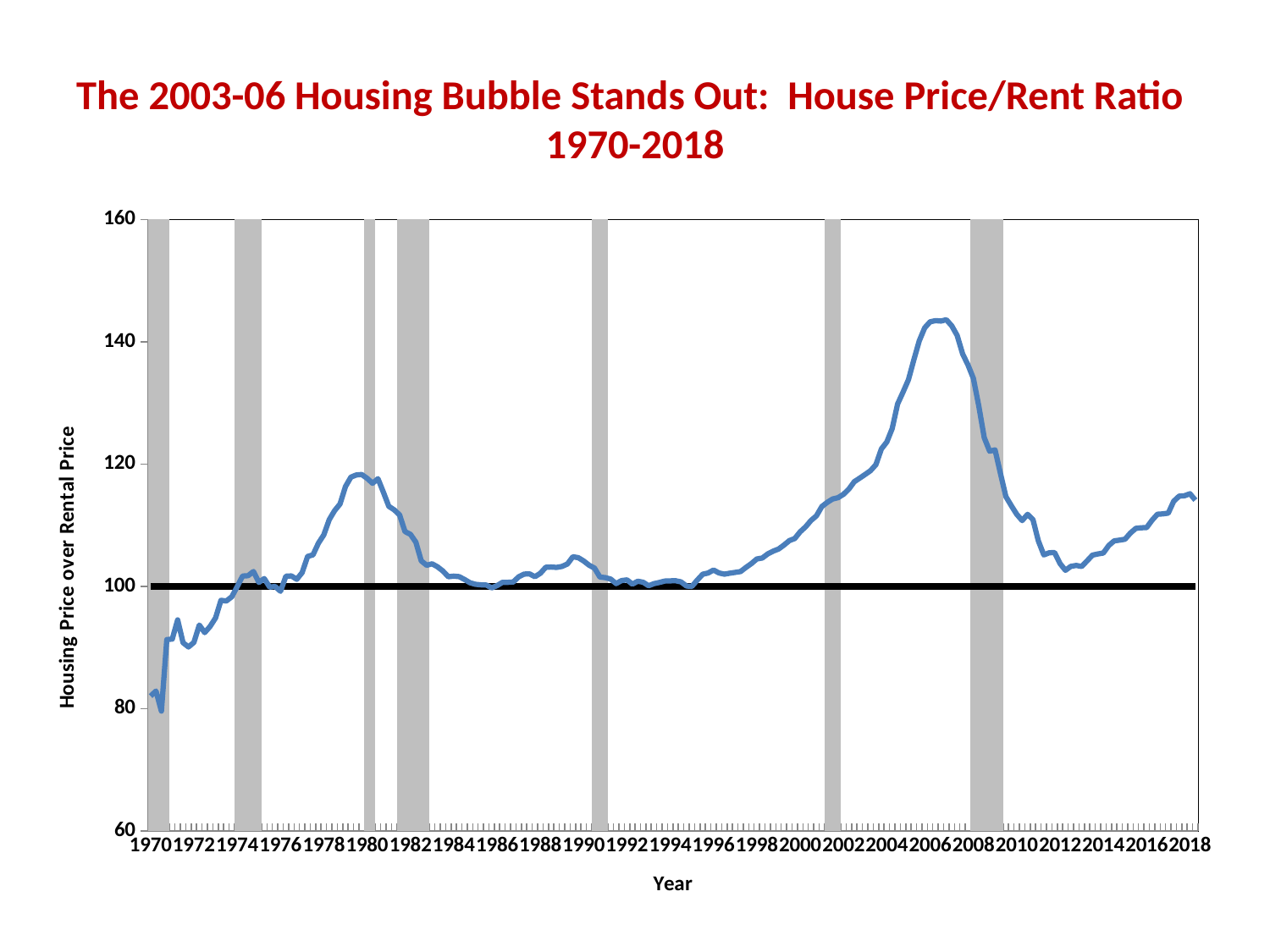
Is the peak value of the house price/rent ratio around 2006 greater or less than 140? greater At what value is the horizontal black reference line drawn? 100 What kind of chart is shown on the slide? line chart Is the value of the house price/rent ratio in 2018 greater or less than 100? greater Does the house price/rent ratio rise or fall between 2006 and 2012? fall Is the value of the house price/rent ratio in 1980 greater or less than 100? greater Does the house price/rent ratio rise or fall between 2012 and 2018? rise What is the title of the chart? The 2003-06 Housing Bubble Stands Out: House Price/Rent Ratio 1970-2018 Which is larger, the peak of the house price/rent ratio around 1980 or the peak around 2006? the peak around 2006